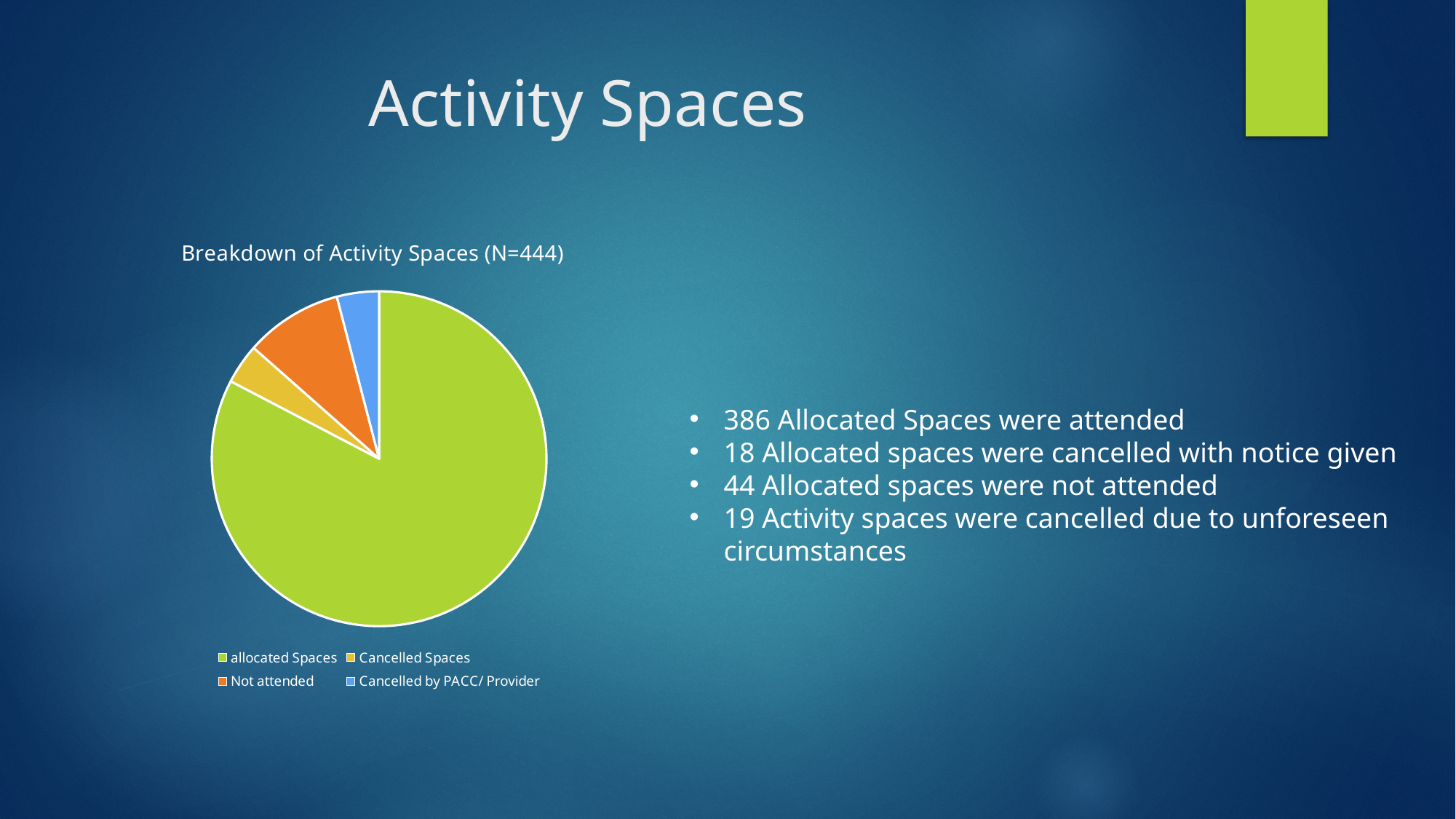
How many slices does the pie chart have? 4 Which slice is larger, allocated Spaces or Not attended? allocated Spaces What is the title of the chart? Breakdown of Activity Spaces (N=444) Which slice is larger, Not attended or Cancelled by PACC/ Provider? Not attended How many entries does the chart legend list? 4 Which category has the largest slice of the pie? allocated Spaces Which slice is larger, Not attended or Cancelled Spaces? Not attended What colour is the allocated Spaces slice in the pie chart? green What kind of chart is shown on the slide? pie chart Does the allocated Spaces slice make up more or less than half of the pie? more